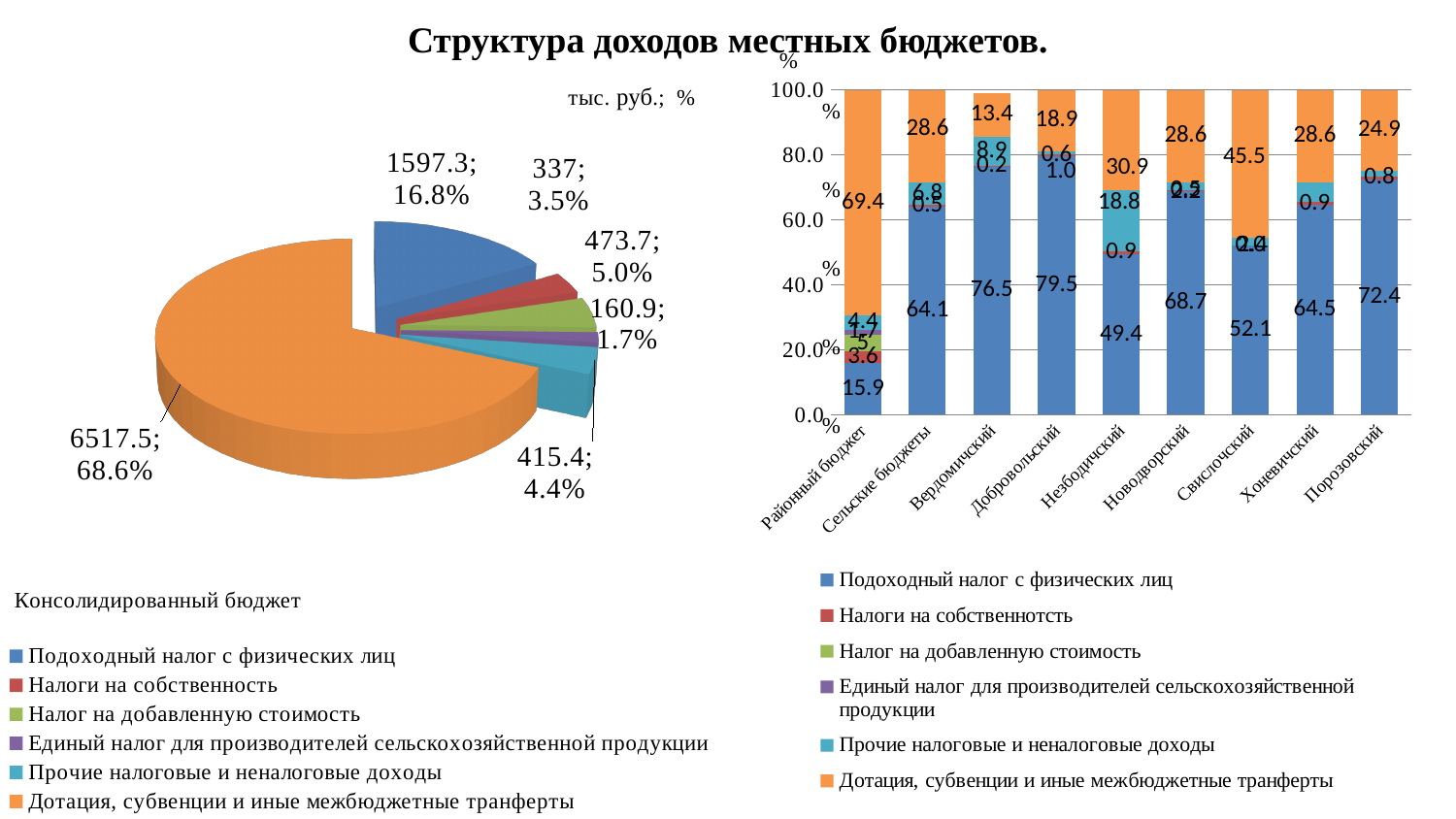
What type of chart is the chart on the left of the slide? Pie chart On the pie chart (Консолидированный бюджет), what value is shown for Дотация, субвенции и иные межбюджетные транферты? 6517.5; 68.6% On the stacked bar chart on the right, what is the value of Подоходный налог с физических лиц for Добровольский? 79.5 How many series does the legend of the stacked bar chart on the right list? 6 On the pie chart (Консолидированный бюджет), which category has the smallest slice? Единый налог для производителей сельскохозяйственной продукции How many categories are shown on the x axis of the stacked bar chart on the right? 9 On the pie chart (Консолидированный бюджет), what value is shown for Налоги на собственность? 337; 3.5% On the stacked bar chart on the right, which category has the lowest value for Подоходный налог с физических лиц? Районный бюджет On the pie chart (Консолидированный бюджет), what share does Подоходный налог с физических лиц have? 16.8% On the pie chart (Консолидированный бюджет), which is larger: Налог на добавленную стоимость or Прочие налоговые и неналоговые доходы? Налог на добавленную стоимость On the stacked bar chart on the right, which category has the highest value for Подоходный налог с физических лиц? Добровольский On the stacked bar chart on the right, what is the value of Дотация, субвенции и иные межбюджетные транферты for Свислочский? 45.5